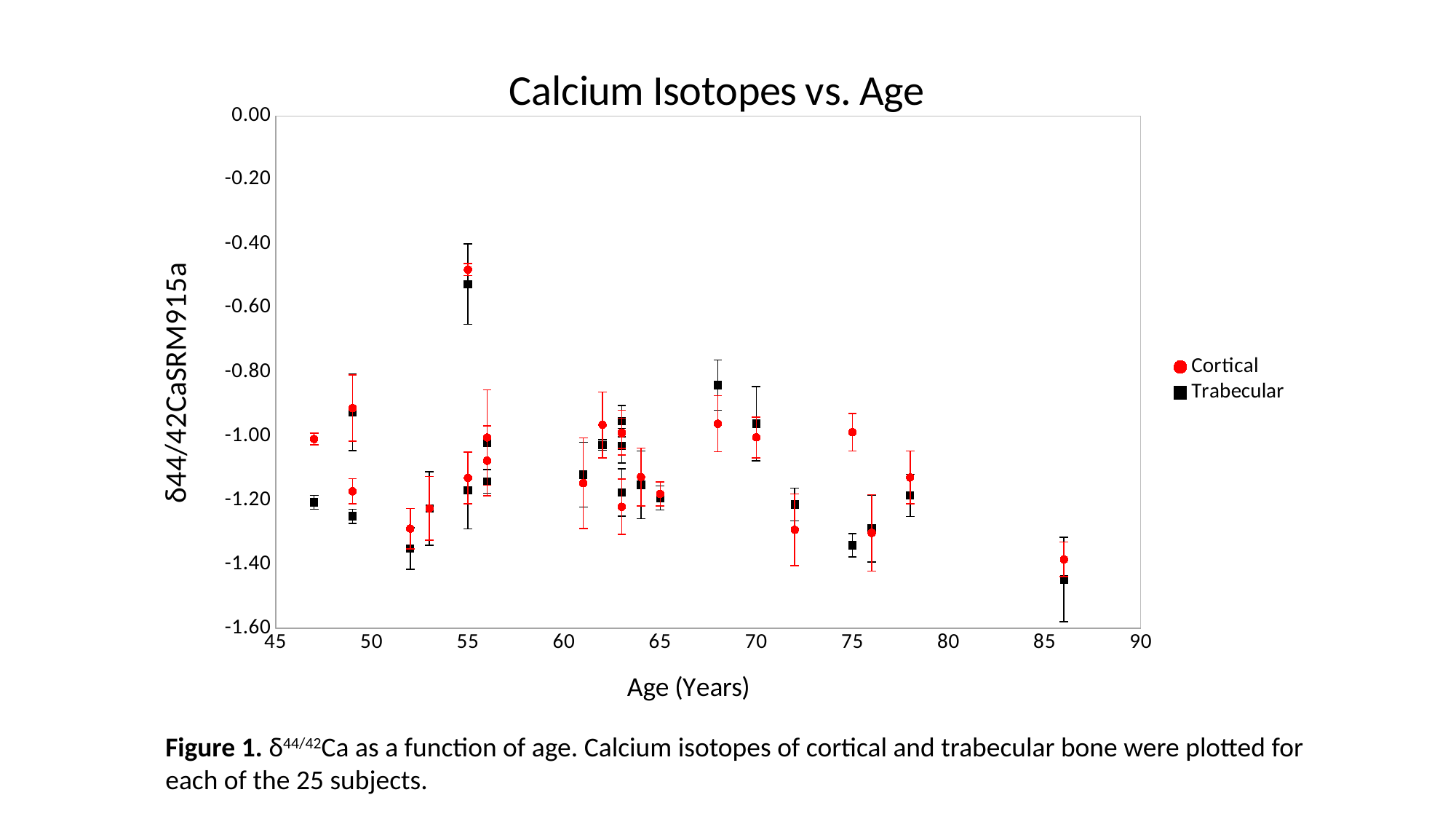
What kind of chart is shown on the slide? Scatter plot At which age does the Cortical series reach its highest value? 55 At which age does the Trabecular series reach its lowest value? 86 What is the title of the chart? Calcium Isotopes vs. Age At age 47, which series has the higher value, Cortical or Trabecular? Cortical Is the Trabecular value at age 68 greater or less than -1.00? greater Is the Trabecular value at age 86 greater or less than -1.20? less How many series does the legend list? 2 At age 68, which series has the higher value, Cortical or Trabecular? Trabecular What are the two series named in the legend? Cortical and Trabecular According to the figure caption, how many subjects were plotted? 25